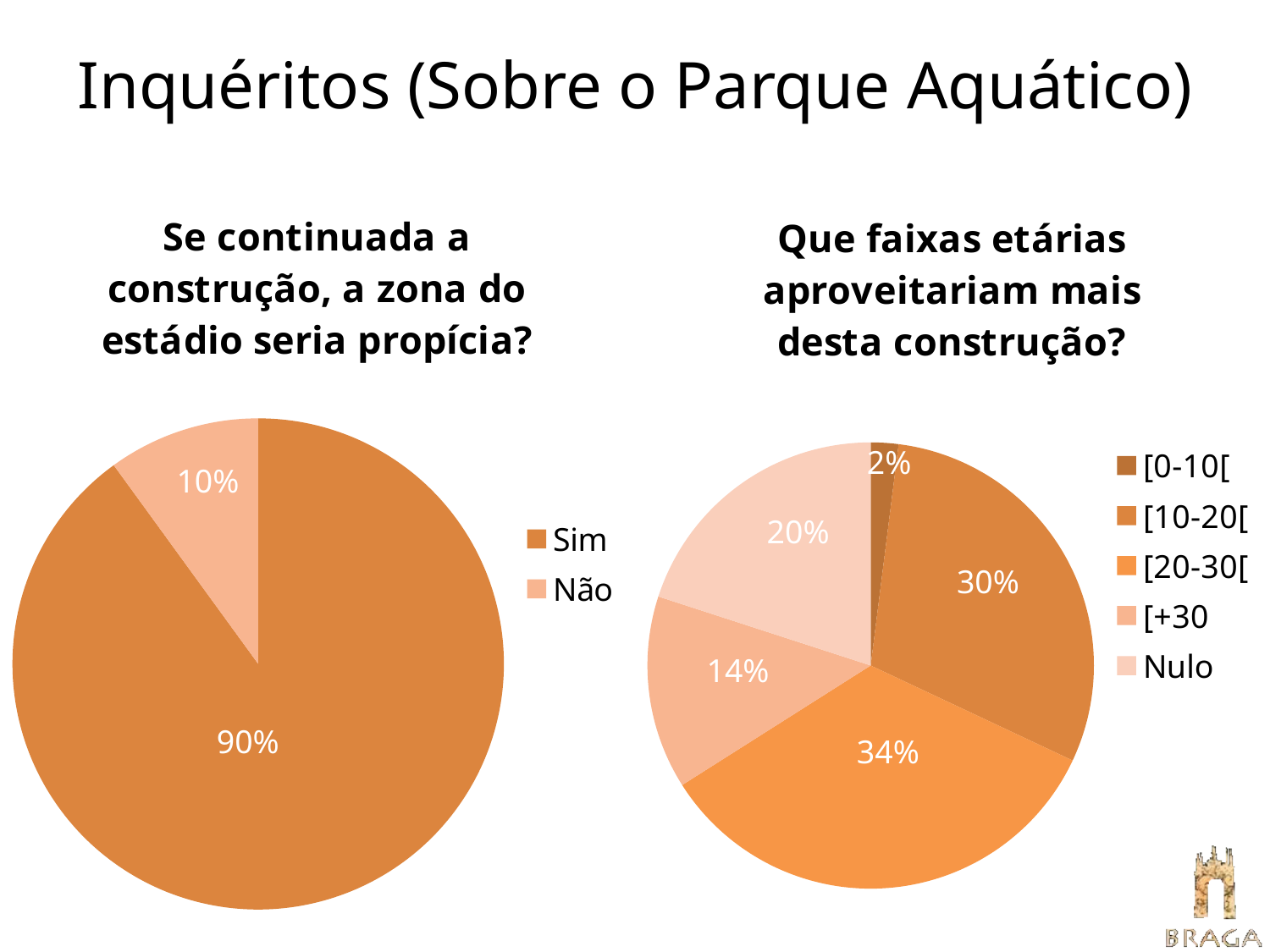
In the right chart ("Que faixas etárias aproveitariam mais desta construção?"), what is the difference between the "[10-20[" and "[+30" shares? 16% How many categories does the legend of the right chart ("Que faixas etárias aproveitariam mais desta construção?") list? 5 In the right chart ("Que faixas etárias aproveitariam mais desta construção?"), what share is "Nulo"? 20% In the right chart ("Que faixas etárias aproveitariam mais desta construção?"), what share is the "[20-30[" age group? 34% In the left chart ("Se continuada a construção, a zona do estádio seria propícia?"), what is the difference between the "Sim" and "Não" shares? 80% In the right chart ("Que faixas etárias aproveitariam mais desta construção?"), which category has the largest share? [20-30[ In the left chart ("Se continuada a construção, a zona do estádio seria propícia?"), what share of responses is "Sim"? 90% In the right chart ("Que faixas etárias aproveitariam mais desta construção?"), which category has the smallest share? [0-10[ What kind of chart is the left chart ("Se continuada a construção, a zona do estádio seria propícia?")? Pie chart How many categories does the legend of the left chart ("Se continuada a construção, a zona do estádio seria propícia?") list? 2